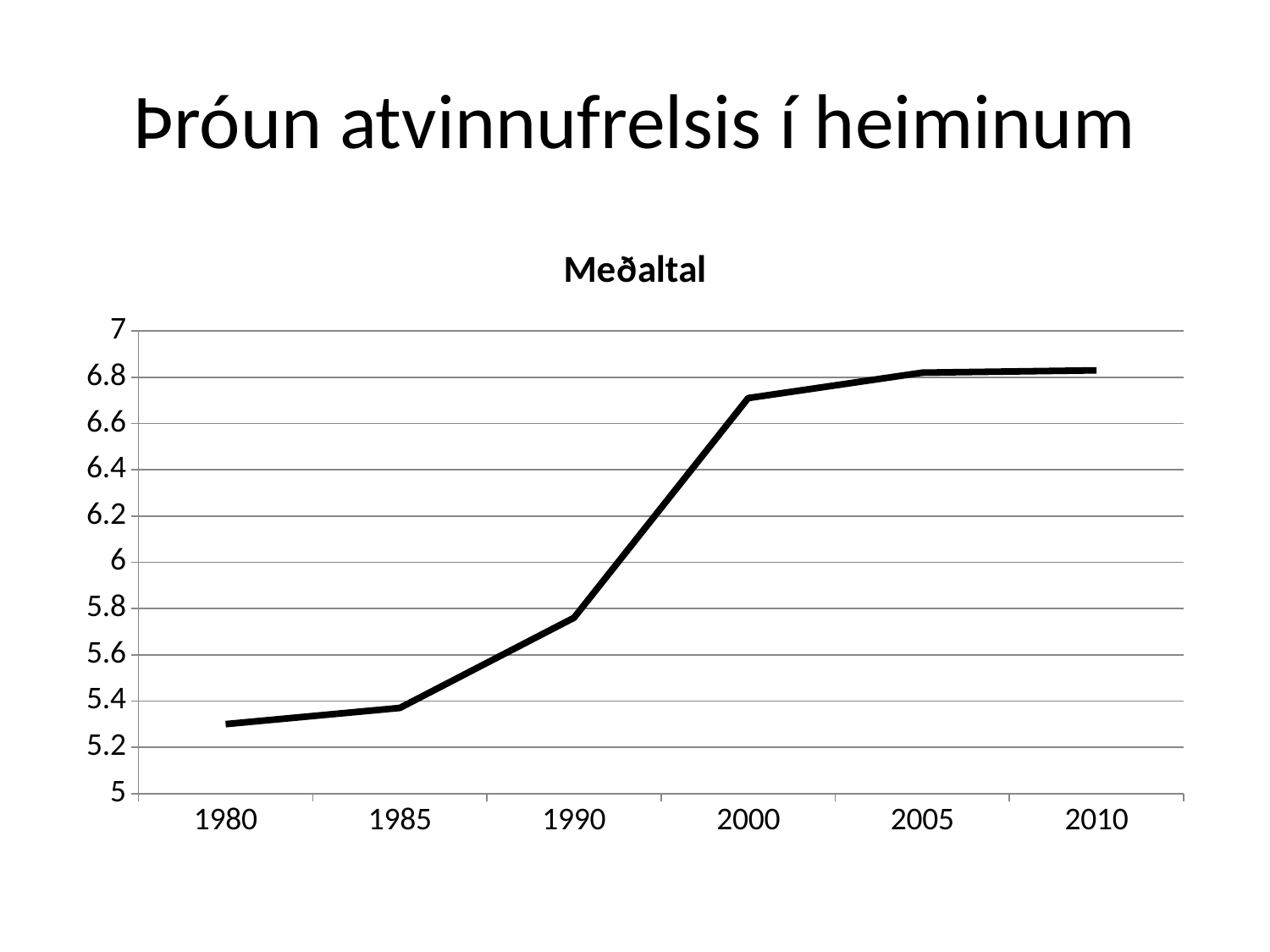
Which is larger, the value for 1985 or the value for 2005? 2005 How many years are plotted on the x axis of the chart? 6 What is the title of the chart? Meðaltal What kind of chart is shown on the slide? line chart Is the value for 2005 greater or less than 6.6? greater Which year has the lowest value? 1980 Is the value for 1990 greater or less than 5.8? less Is the value for 1985 greater or less than 5.2? greater Do the values rise or fall from 1980 to 2010? rise Which is larger, the value for 1990 or the value for 2000? 2000